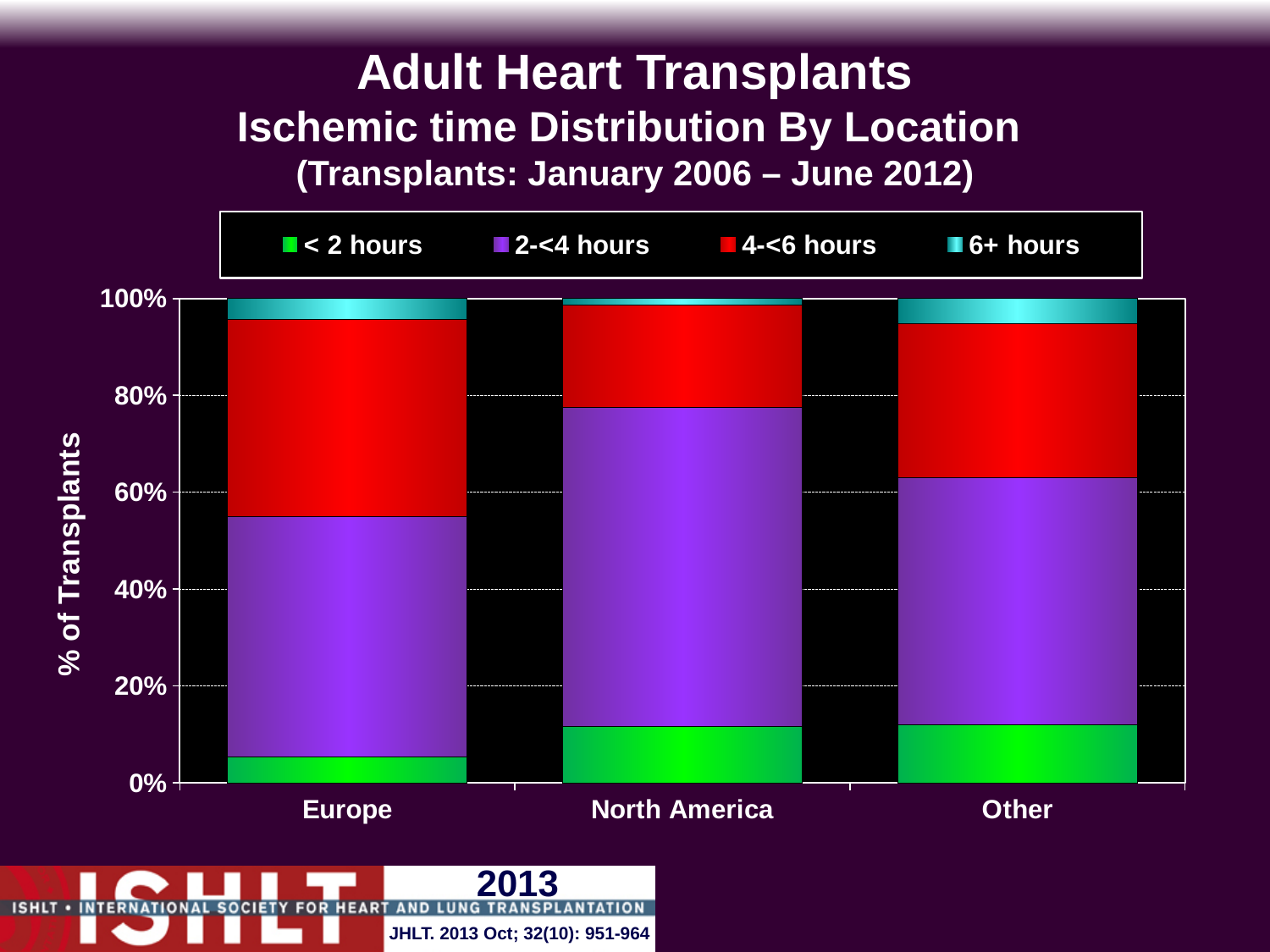
What kind of chart is shown on the slide? Stacked bar chart Is the combined share of transplants with ischemic time under 4 hours in Europe greater or less than 60%? less What is the label on the y axis of the chart? % of Transplants Which location has the smallest 6+ hours segment? North America Is the 4-<6 hours segment larger for Europe or for North America? Europe Is the < 2 hours share for North America greater or less than 20%? less Which location has the smallest < 2 hours segment? Europe How many locations are shown on the x axis of the chart? 3 How many ischemic time categories does the legend list? 4 Is the combined share of transplants with ischemic time under 4 hours in North America greater or less than 60%? greater Which location has the largest 2-<4 hours segment? North America What does each stacked bar total? 100%